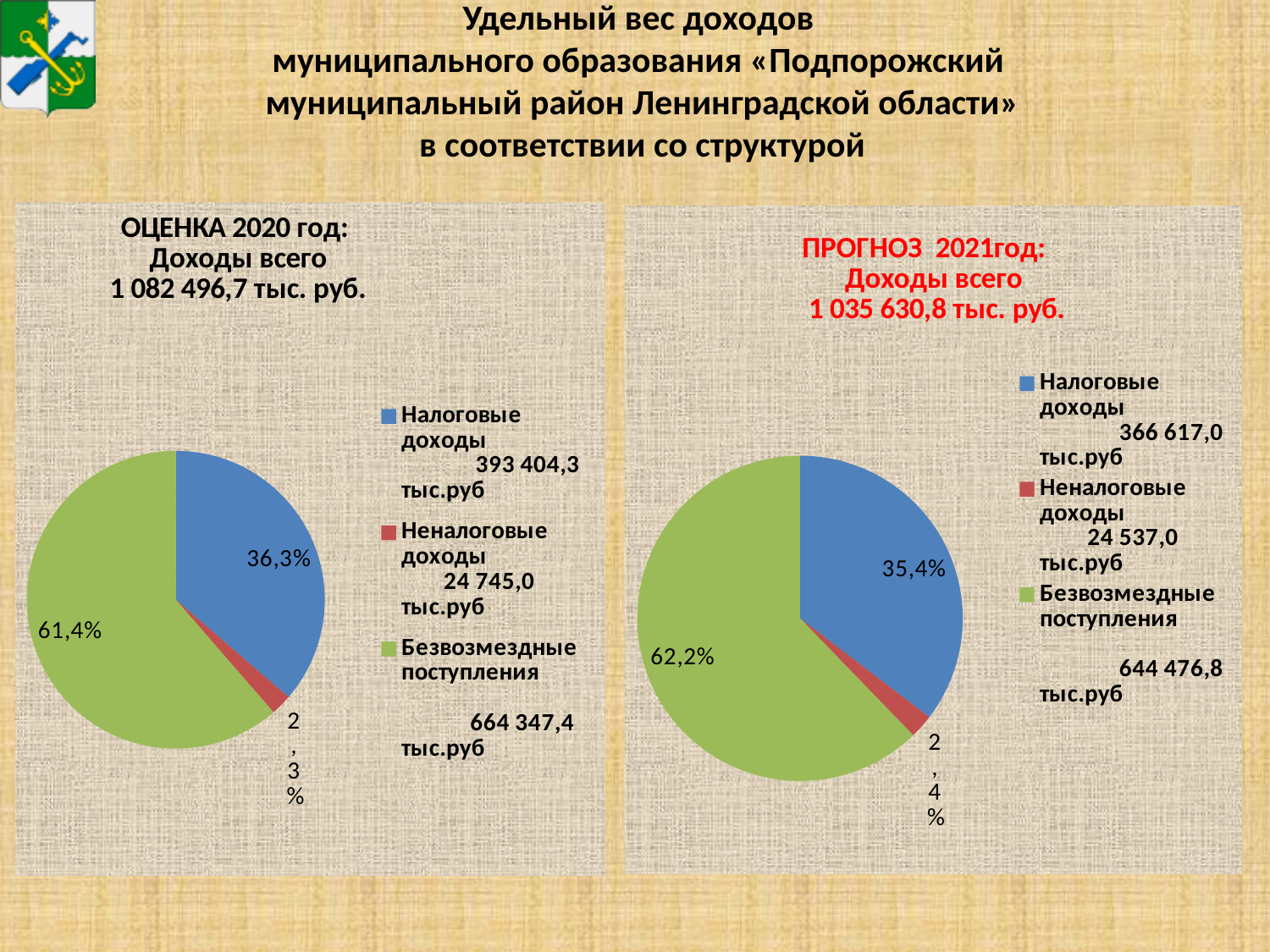
In the ПРОГНОЗ 2021 год chart, which category has the largest slice? Безвозмездные поступления In the ОЦЕНКА 2020 год chart, what share of the pie is Налоговые доходы? 36,3% In the ОЦЕНКА 2020 год chart, which category has the smallest slice? Неналоговые доходы In the ОЦЕНКА 2020 год chart legend, what amount in тыс.руб is given for Налоговые доходы? 393 404,3 тыс.руб In the ОЦЕНКА 2020 год chart, what share of the pie is Неналоговые доходы? 2,3% In the ПРОГНОЗ 2021 год chart, what share of the pie is Неналоговые доходы? 2,4% In the ПРОГНОЗ 2021 год chart, which is larger: the Налоговые доходы slice or the Безвозмездные поступления slice? Безвозмездные поступления In the ОЦЕНКА 2020 год chart, what is the difference in percentage points between Безвозмездные поступления and Налоговые доходы? 25,1 What type of chart is used on the left (ОЦЕНКА 2020 год) side of the slide? pie chart How many slices does the ПРОГНОЗ 2021 год pie chart have? 3